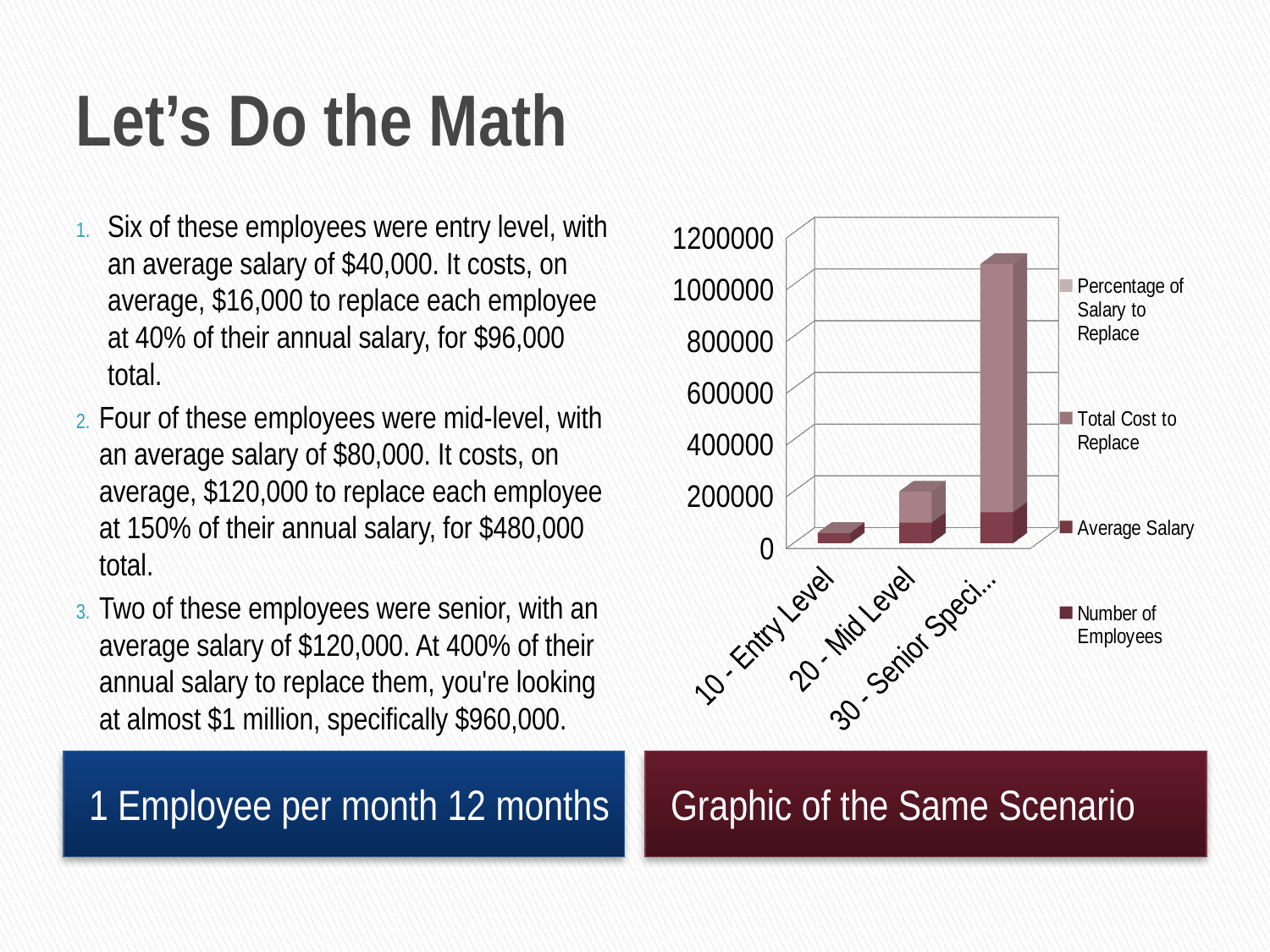
How many categories are shown on the x axis of the chart? 3 Which category has the tallest stacked bar in the chart? 30 - Senior Speci... What kind of chart is shown on the slide? bar chart Which stacked bar is taller, 20 - Mid Level or 30 - Senior Speci...? 30 - Senior Speci... Is the total height of the stacked bar for 30 - Senior Speci... greater or less than 800000? greater Which category has the shortest stacked bar in the chart? 10 - Entry Level How many series does the chart legend list? 4 Is the total height of the stacked bar for 10 - Entry Level greater or less than 200000? less What is the highest value labelled on the chart's vertical axis? 1200000 Do the stacked bar heights rise or fall moving from 10 - Entry Level to 30 - Senior Speci... along the x axis? rise Is the total height of the stacked bar for 20 - Mid Level greater or less than 400000? less Which series is listed last in the chart legend? Number of Employees